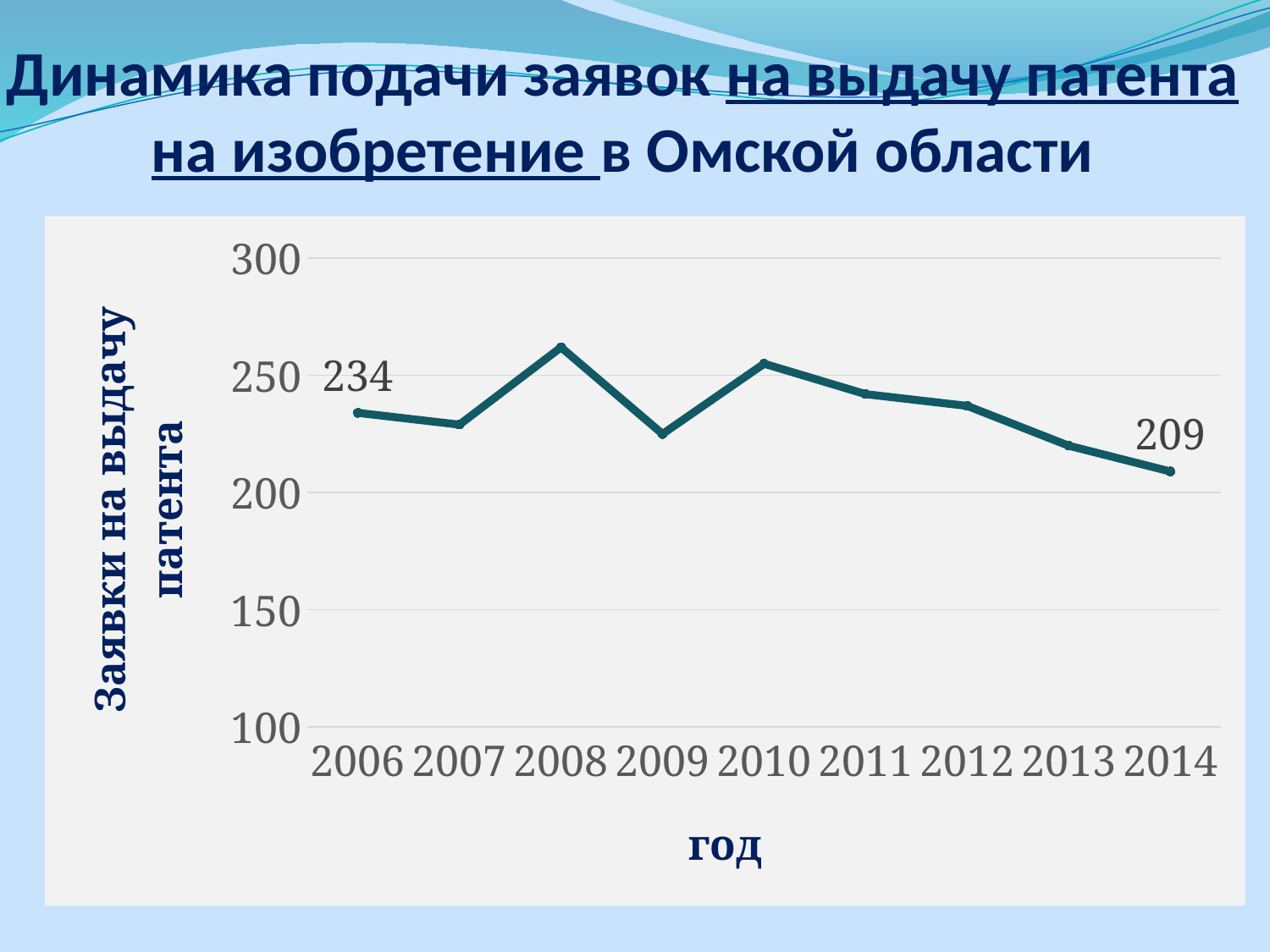
What is the value for 2014? 209 Which is larger, the value for 2006 or the value for 2014? 2006 What kind of chart is shown on the slide? line chart Overall, do the values rise or fall from 2006 to 2014? fall Is the value for 2008 greater or less than 250? greater How many years are plotted on the x axis? 9 What is the difference between the values for 2006 and 2014? 25 Which year has the lowest value? 2014 Which year has the highest value? 2008 Is the value for 2009 greater or less than 250? less What is the value for 2006? 234 Which is larger, the value for 2008 or the value for 2009? 2008